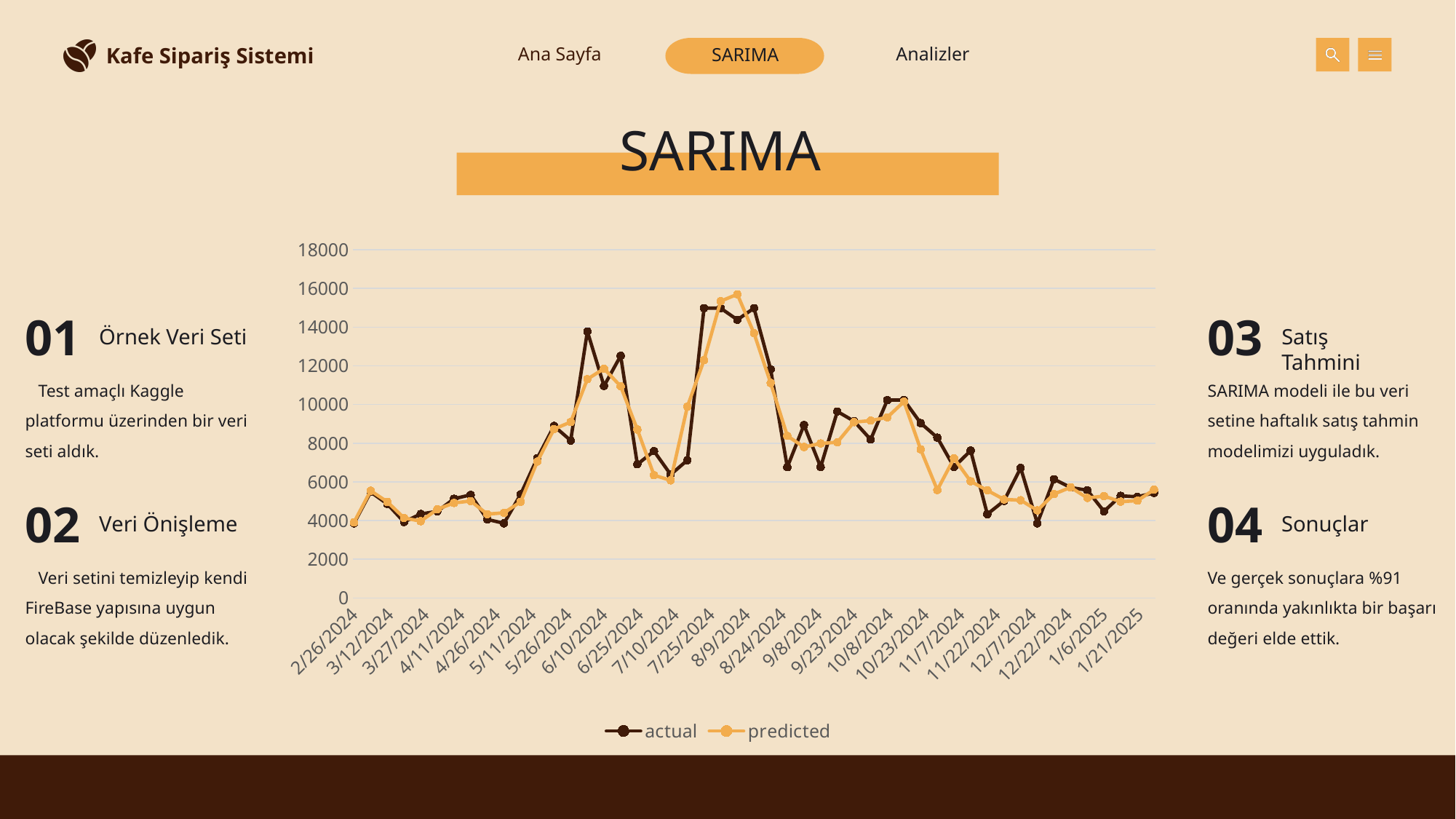
What are the two series named in the chart legend? actual and predicted Between 8/9/2024 and 12/7/2024, does the actual series generally rise or fall? fall How many series does the chart legend list? 2 Is the actual value on 7/25/2024 greater or less than 14000? greater Is the actual value on 2/26/2024 greater or less than 6000? less What kind of chart is shown on the slide? line chart Is the actual value on 6/10/2024 greater or less than 10000? greater On 7/25/2024, which series has the larger value, actual or predicted? actual What is the highest value shown on the chart's vertical axis? 18000